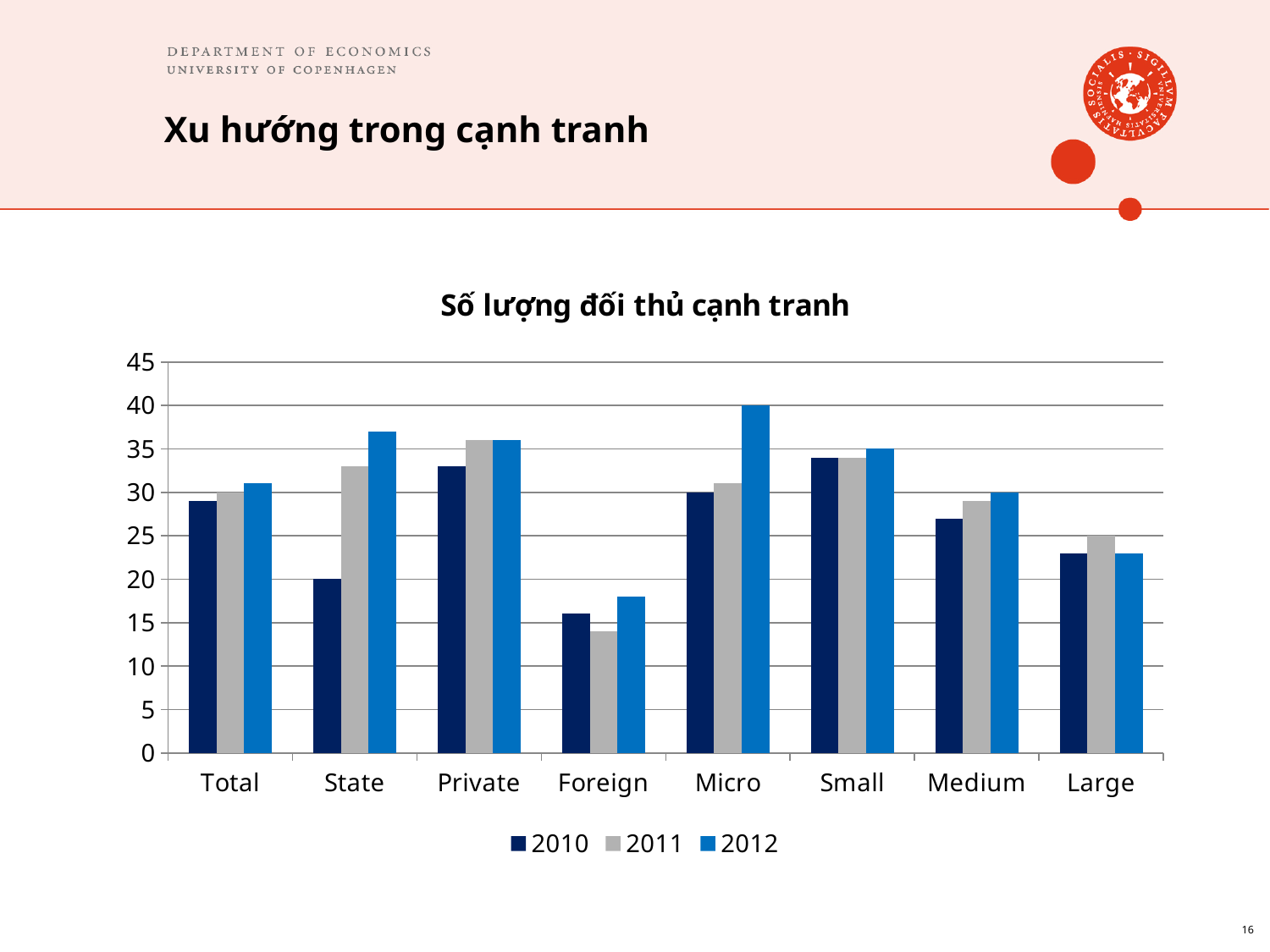
Which is larger, the 2010 value for State or the 2010 value for Private? Private Do the values for State rise or fall from 2010 to 2012? rise What kind of chart is shown on the slide? bar chart Is the 2010 value for Foreign greater or less than 20? less Is the 2011 value for Private greater or less than 35? greater Which category has the highest 2012 value? Micro Which is larger, the 2012 value for Micro or the 2012 value for Small? Micro How many series does the legend list? 3 How many categories are shown on the x axis? 8 Which category has the lowest 2011 value? Foreign Is the 2012 value for State greater or less than 35? greater What is the title of the chart? Số lượng đối thủ cạnh tranh